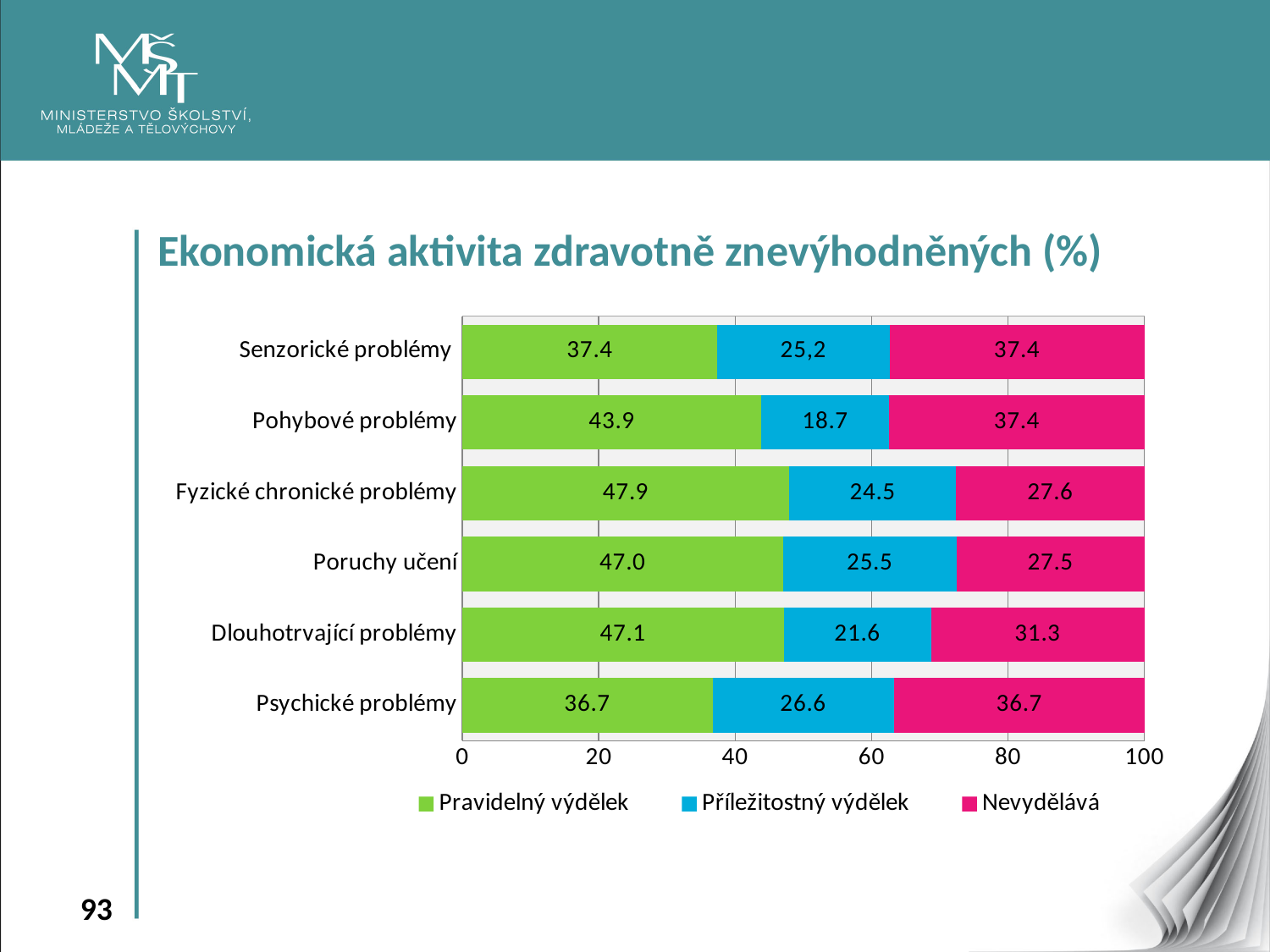
Which category has the highest value for Příležitostný výdělek? Psychické problémy What is the value of Nevydělává for Dlouhotrvající problémy? 31.3 How many categories are plotted on the chart? 6 What type of chart is shown on the slide? stacked bar chart Which category has the lowest value for Příležitostný výdělek? Pohybové problémy What is the title of the chart? Ekonomická aktivita zdravotně znevýhodněných (%) Which category has the highest value for Pravidelný výdělek? Fyzické chronické problémy What is the value of Pravidelný výdělek for Pohybové problémy? 43.9 How many series does the legend list? 3 Which is larger: Nevydělává for Senzorické problémy or Nevydělává for Fyzické chronické problémy? Senzorické problémy What is the value of Příležitostný výdělek for Poruchy učení? 25.5 What is the difference between Pravidelný výdělek and Příležitostný výdělek for Pohybové problémy? 25.2